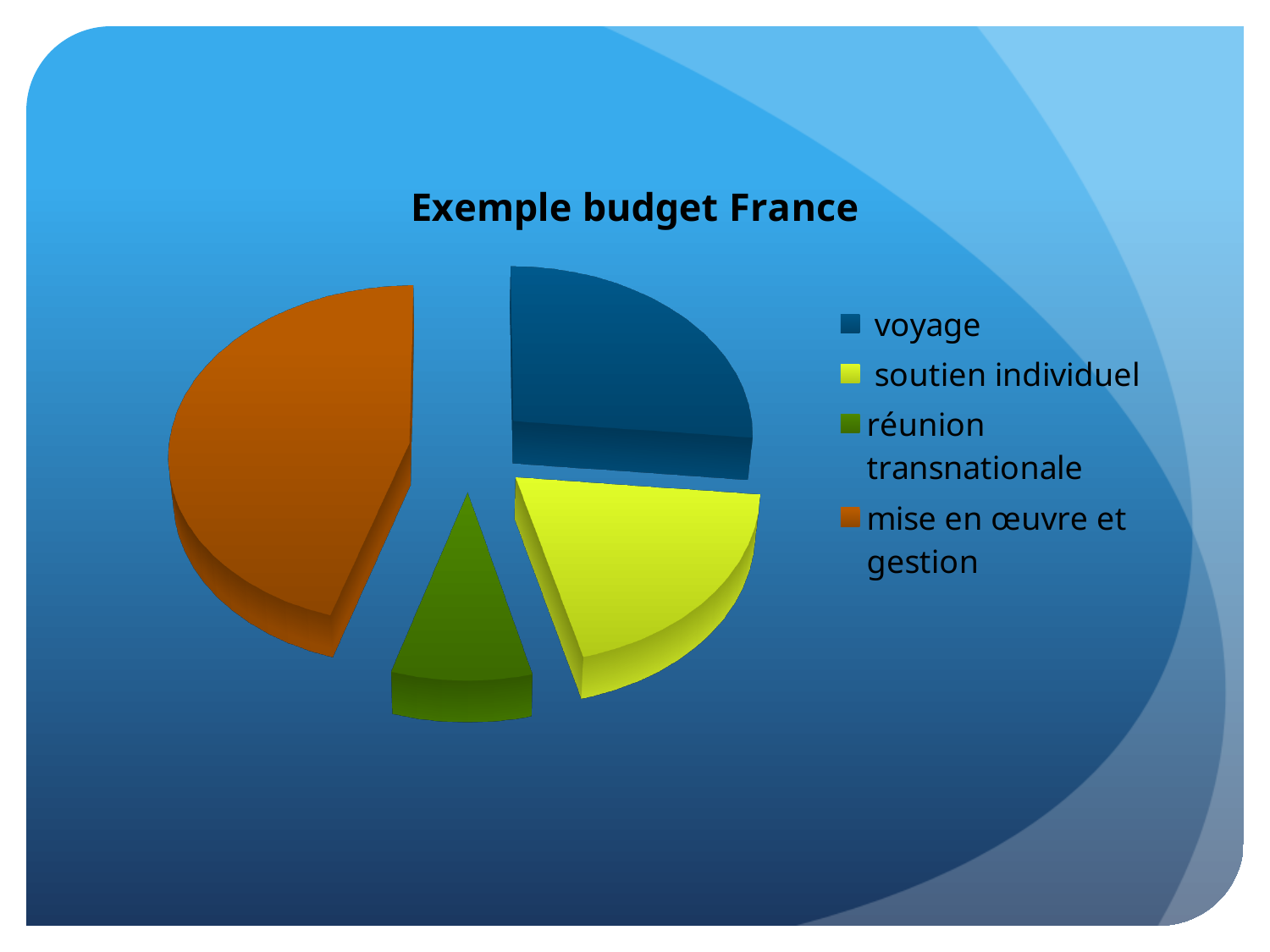
Which category has the largest slice of the pie? mise en œuvre et gestion How many slices does the pie chart have? 4 What is the title of the chart? Exemple budget France Which slice is larger, mise en œuvre et gestion or voyage? mise en œuvre et gestion How many entries does the legend list? 4 Which slice is larger, soutien individuel or réunion transnationale? soutien individuel What kind of chart is shown on the slide? pie chart Which slice is larger, voyage or réunion transnationale? voyage Which category has the smallest slice of the pie? réunion transnationale Which colour represents voyage in the pie chart? blue